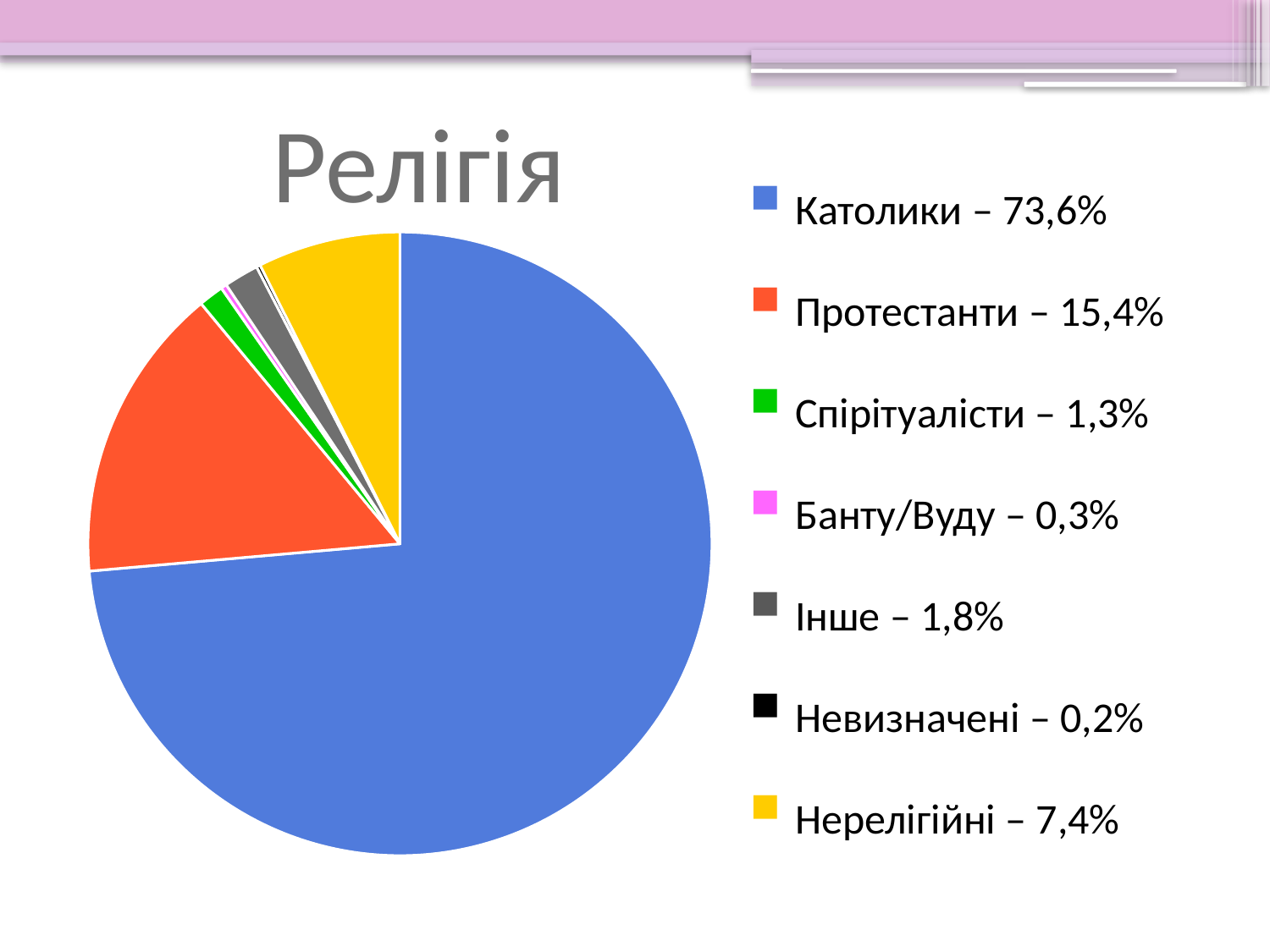
What share of the pie is Банту/Вуду? 0,3% What is the difference between the shares of Католики and Протестанти? 58,2% Which is larger, the share of Спірітуалісти or the share of Інше? Інше Which category has the smallest share of the pie? Невизначені Which category has the largest share of the pie? Католики What share of the pie is Нерелігійні? 7,4% What colour is the slice for Нерелігійні? yellow What is the chart's title? Релігія What share of the pie is Католики? 73,6% What share of the pie is Протестанти? 15,4% How many categories does the legend list? 7 What kind of chart is shown on the slide? pie chart